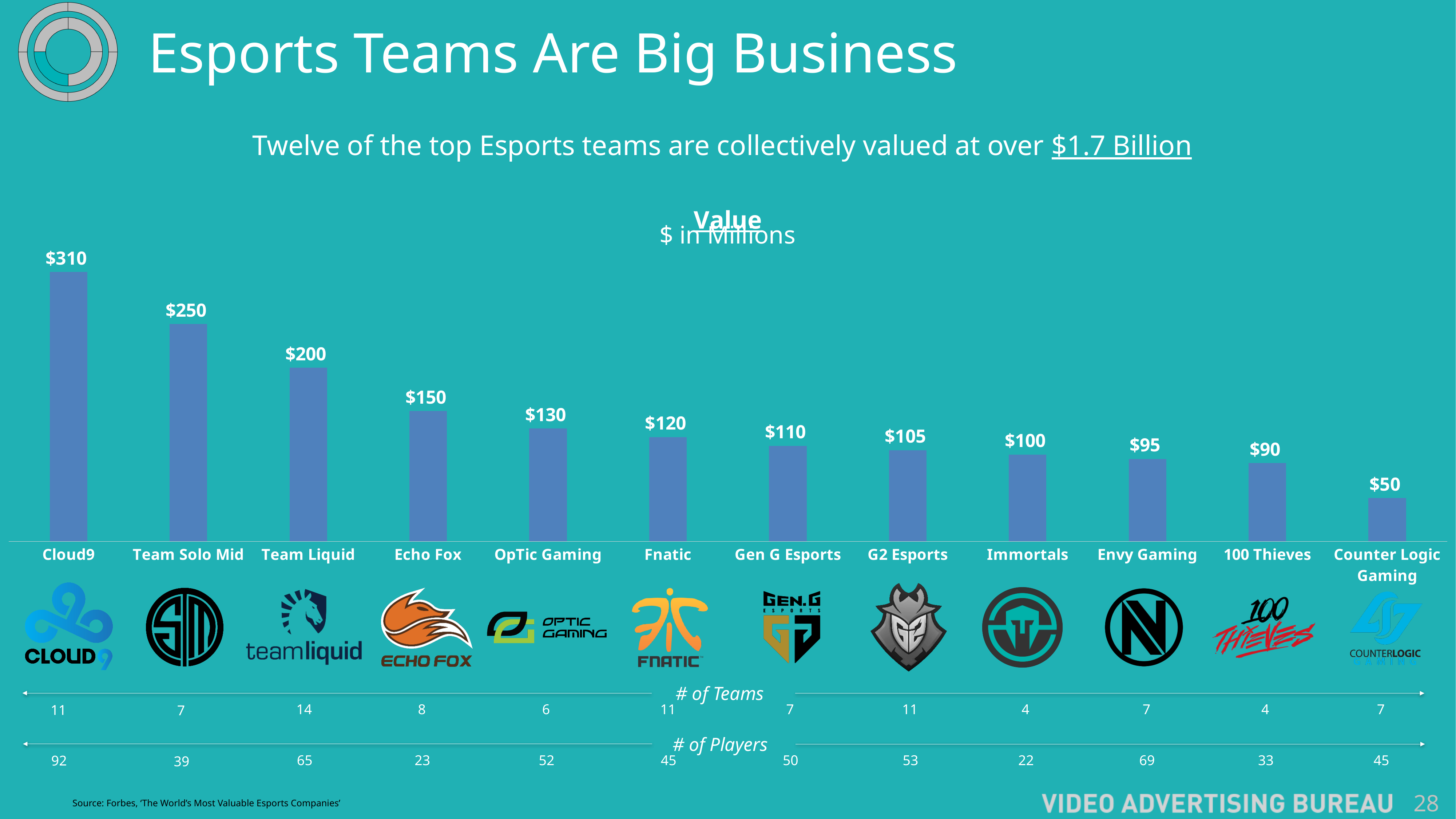
Which team has the highest value in the chart? Cloud9 How many teams are shown in the bar chart? 12 Which team has the lowest value in the chart? Counter Logic Gaming Which has a larger value, Team Liquid or OpTic Gaming? Team Liquid What kind of chart is shown on the slide? Bar chart What is the value shown for Fnatic? $120 What is the value shown for Envy Gaming? $95 What is the value shown for Cloud9? $310 Do the values rise or fall from left to right across the chart? Fall What is the difference between the values for Echo Fox and 100 Thieves? $60 Which has a larger value, G2 Esports or Immortals? G2 Esports What is the difference between the values for Cloud9 and Team Solo Mid? $60